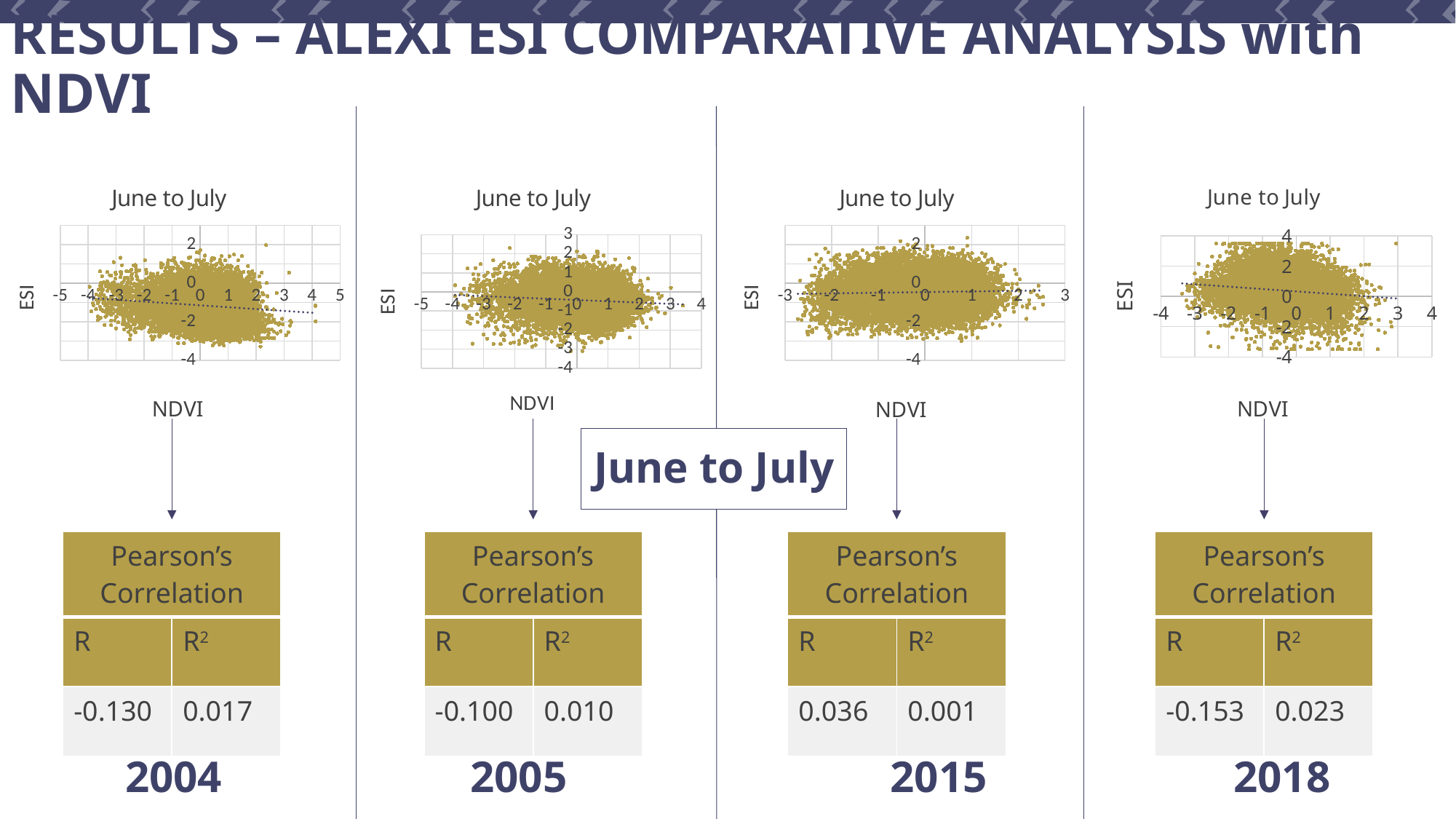
Which year's chart has the highest R² value? 2018 Which year's chart has the lowest R² value? 2015 For the 2015 chart, what is the Pearson's correlation R value? 0.036 For the 2018 chart, what is the R² value? 0.023 How many scatter charts are on the slide? 4 What is the y-axis label of the scatter charts? ESI Which year has the larger R value, 2004 or 2015? 2015 What is the difference between the R² values for 2018 and 2004? 0.006 For the 2005 chart, what is the R² value? 0.010 For the 2004 chart, what is the Pearson's correlation R value? -0.130 What is the title of each scatter chart on the slide? June to July What kind of chart is shown for 2004? Scatter chart